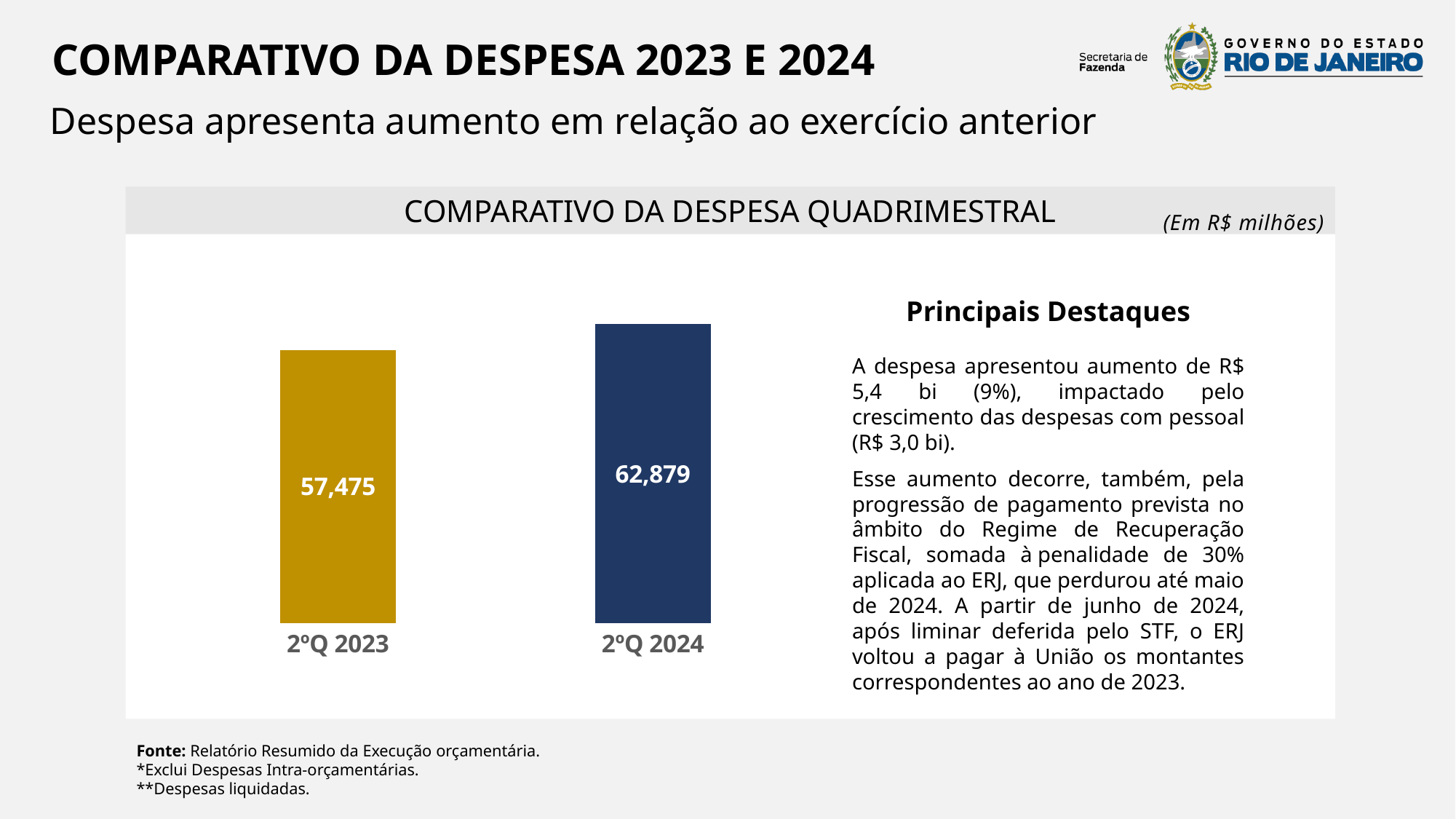
Which category has the highest value? 2ºQ 2024 Which is larger, the value for 2ºQ 2023 or the value for 2ºQ 2024? 2ºQ 2024 What is the difference between the values for 2ºQ 2024 and 2ºQ 2023? 5,404 Do the values rise or fall from 2ºQ 2023 to 2ºQ 2024? Rise What is the title of the chart? COMPARATIVO DA DESPESA QUADRIMESTRAL In what unit are the chart values expressed? Em R$ milhões What kind of chart is shown on the slide? Bar chart What is the value for 2ºQ 2024? 62,879 How many categories are shown in the chart? 2 Which category has the lowest value? 2ºQ 2023 What is the value for 2ºQ 2023? 57,475